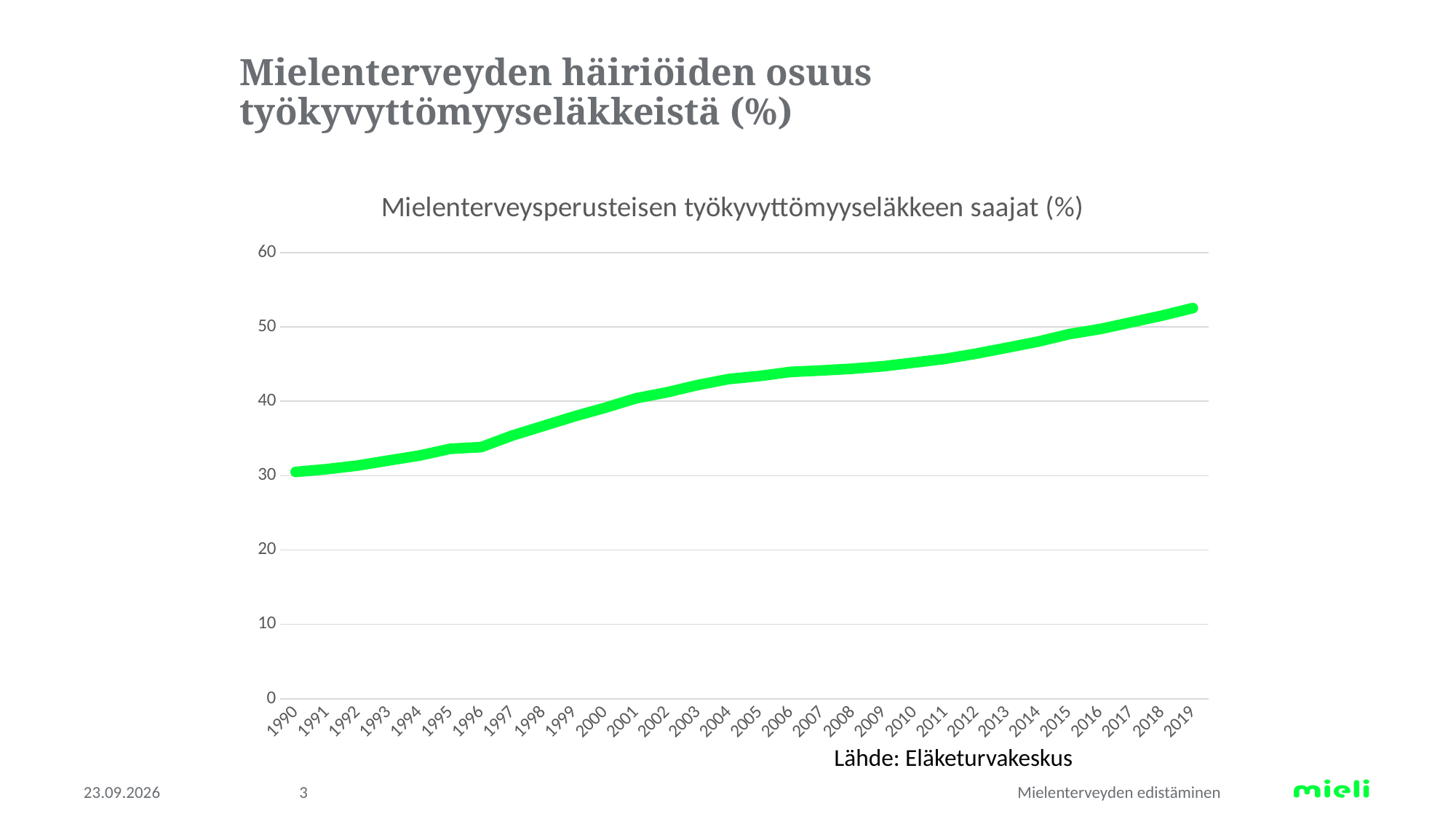
Which year has the lowest value in the chart? 1990 Is the value for 2010 greater or less than 40? greater Do the values rise or fall from 1990 to 2019? Rise What is the title of the chart? Mielenterveysperusteisen työkyvyttömyyseläkkeen saajat (%) How many years are plotted along the x axis of the chart? 30 Is the value for 2019 greater or less than 50? greater What kind of chart is shown on the slide? Line chart Is the value for 1996 greater or less than 40? less What source is cited below the chart? Eläketurvakeskus Which year has the larger value, 1995 or 2005? 2005 Which year has the highest value in the chart? 2019